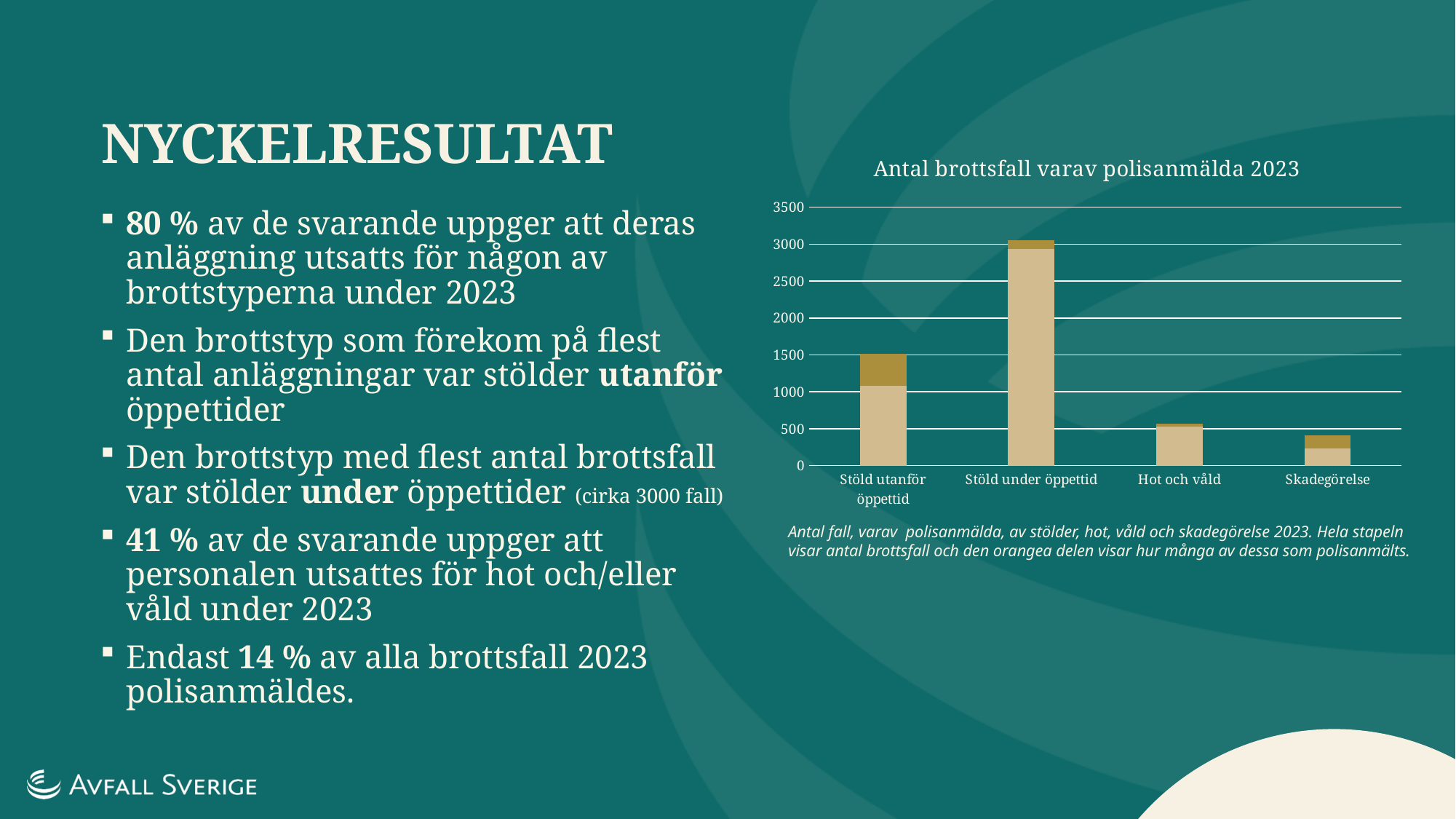
Is the total bar for Skadegörelse greater or less than 500? less Is the total bar for Stöld utanför öppettid greater or less than 1000? greater Which bar is taller: Stöld utanför öppettid or Hot och våld? Stöld utanför öppettid What is the title of the chart? Antal brottsfall varav polisanmälda 2023 Is the total bar for Hot och våld greater or less than 1000? less What kind of chart is shown on the slide? bar chart How many categories are shown on the x axis of the chart? 4 Which category has the tallest bar in the chart? Stöld under öppettid Which bar is taller: Hot och våld or Skadegörelse? Hot och våld What is the highest value shown on the chart's y axis? 3500 Which category has the shortest bar in the chart? Skadegörelse